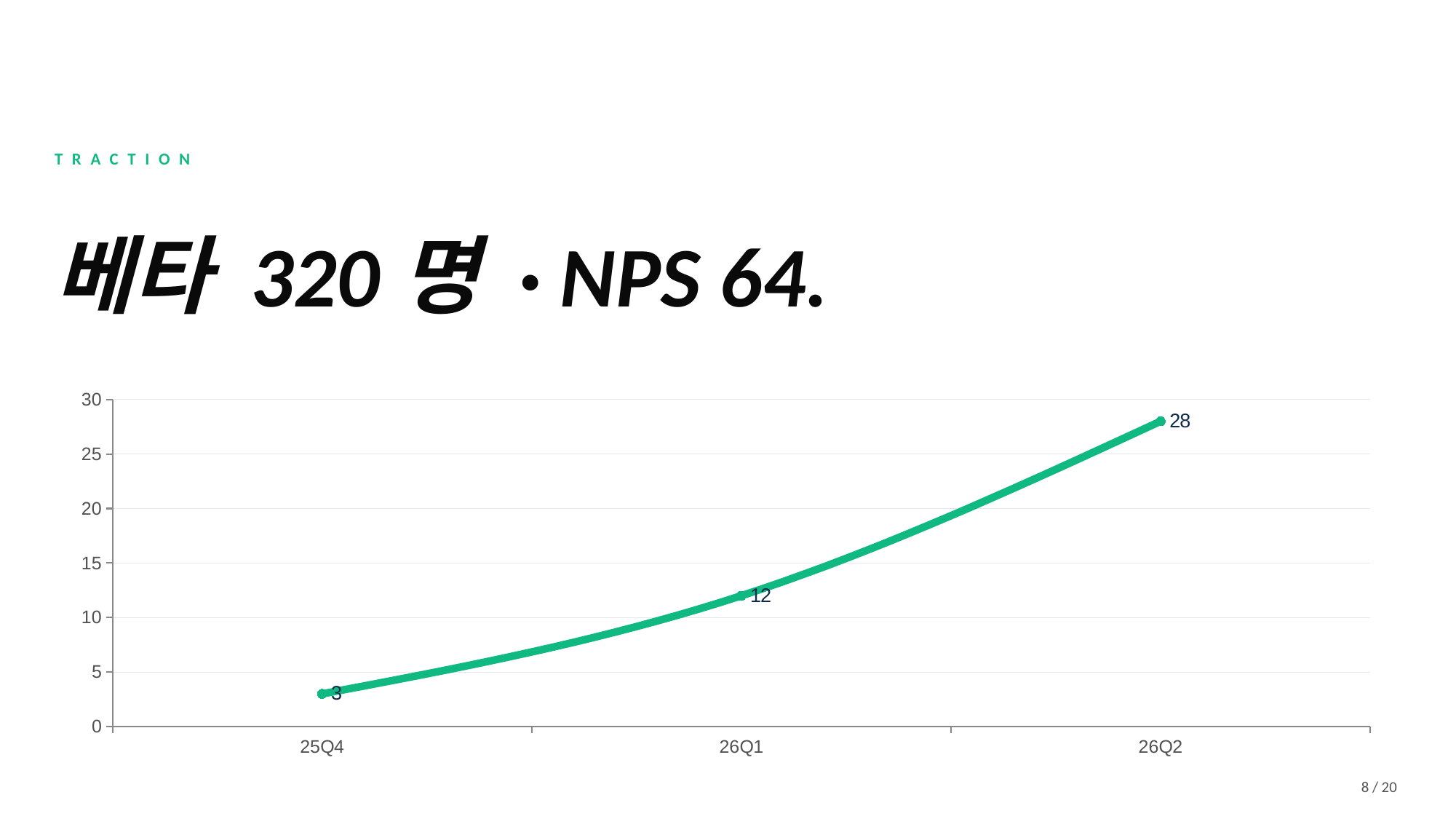
Which quarter has the highest value? 26Q2 What is the difference between the values for 26Q1 and 25Q4? 9 What is the difference between the values for 26Q2 and 26Q1? 16 What is the value for 26Q2? 28 Which quarter has the lowest value? 25Q4 How many data points are plotted on the chart? 3 What is the value for 26Q1? 12 Which is larger, the value for 26Q1 or the value for 25Q4? 26Q1 Is the value for 26Q2 greater or less than 25? greater Do the values rise or fall from 25Q4 to 26Q2? rise What is the value for 25Q4? 3 What kind of chart is shown on the slide? line chart